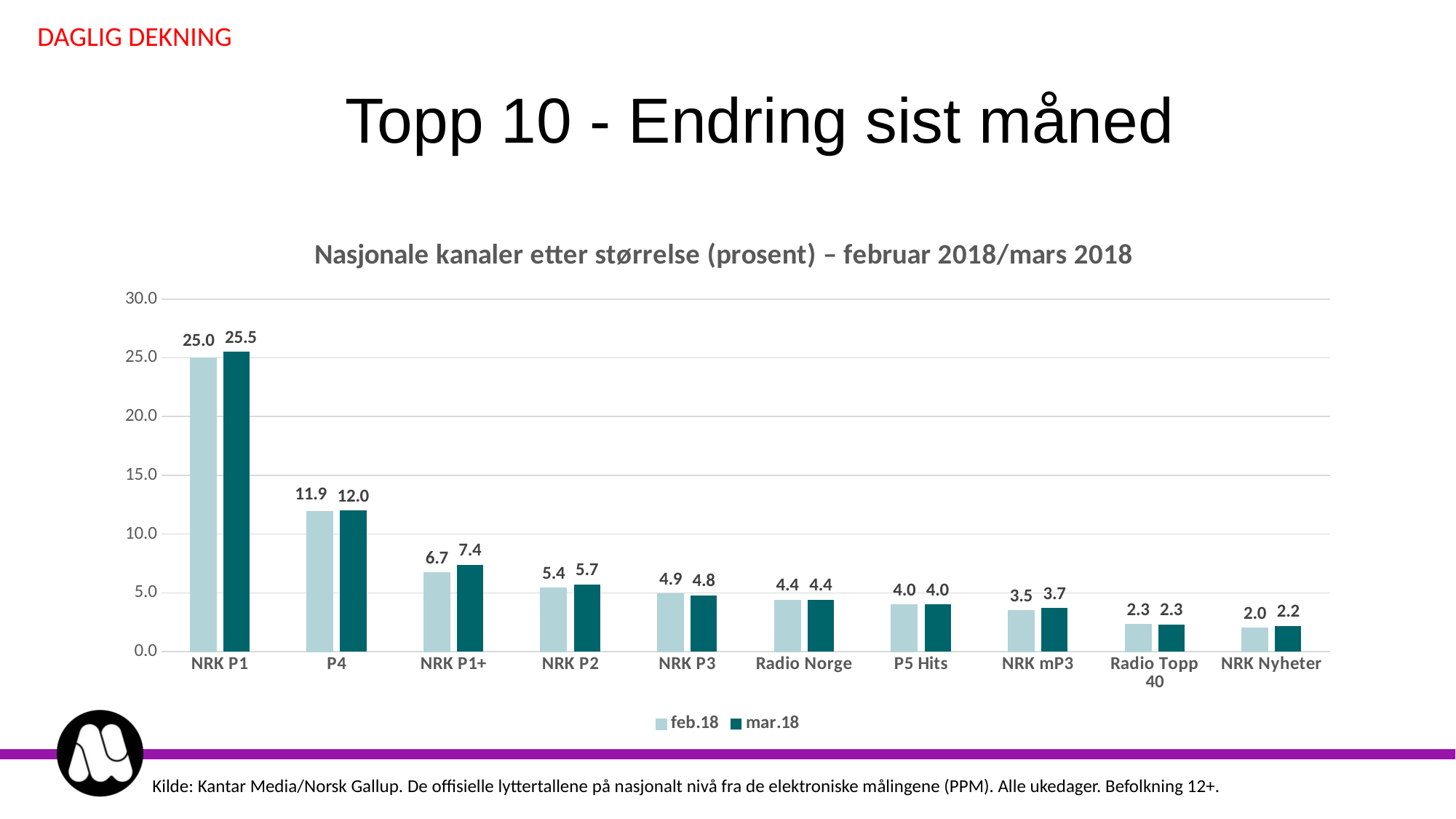
Which channel has the highest mar.18 value? NRK P1 Which channel has the lowest feb.18 value? NRK Nyheter What is the difference between the mar.18 and feb.18 values for NRK P1+? 0.7 What is the mar.18 value for NRK P1? 25.5 What is the mar.18 value for Radio Topp 40? 2.3 Is the mar.18 value for P4 greater or less than 10.0? greater What is the title of the chart? Nasjonale kanaler etter størrelse (prosent) – februar 2018/mars 2018 What is the feb.18 value for NRK P1+? 6.7 How many series does the legend list? 2 How many channels are shown on the x axis? 10 Which is larger for NRK P3: the feb.18 value or the mar.18 value? feb.18 What kind of chart is shown on the slide? bar chart